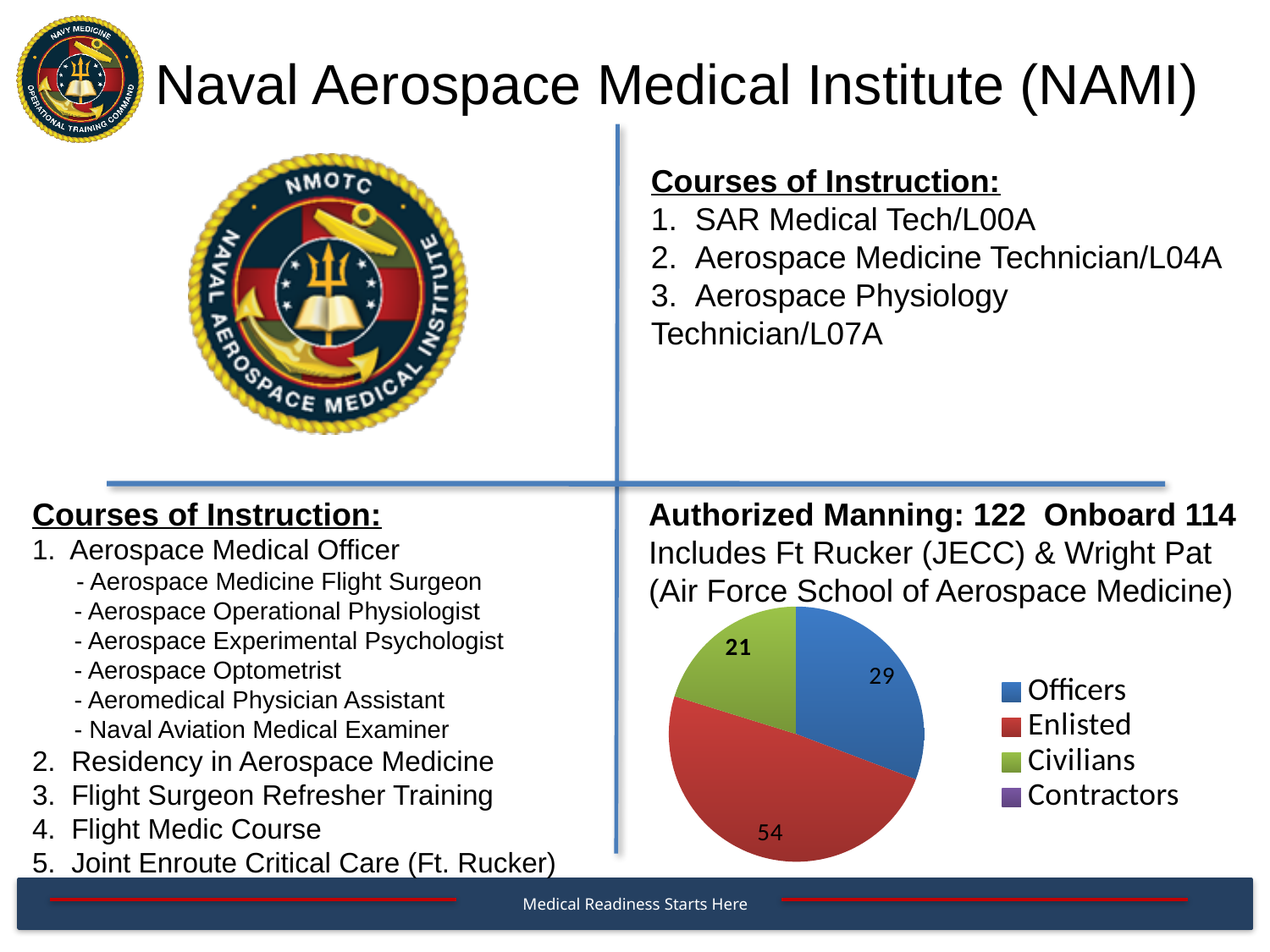
Which category has the largest slice in the pie chart? Enlisted Which legend entry of the pie chart is shown in purple? Contractors How many entries does the legend of the pie chart list? 4 Which is larger in the pie chart, Officers or Civilians? Officers What value is shown for Officers in the pie chart? 29 What value is shown for Civilians in the pie chart? 21 What colour represents Enlisted in the pie chart? Red What value is shown for Enlisted in the pie chart? 54 What is the difference between the Officers value and the Civilians value in the pie chart? 8 What is the difference between the Enlisted value and the Officers value in the pie chart? 25 What kind of chart is shown on the slide? Pie chart Of the slices with printed values, which category has the smallest value in the pie chart? Civilians